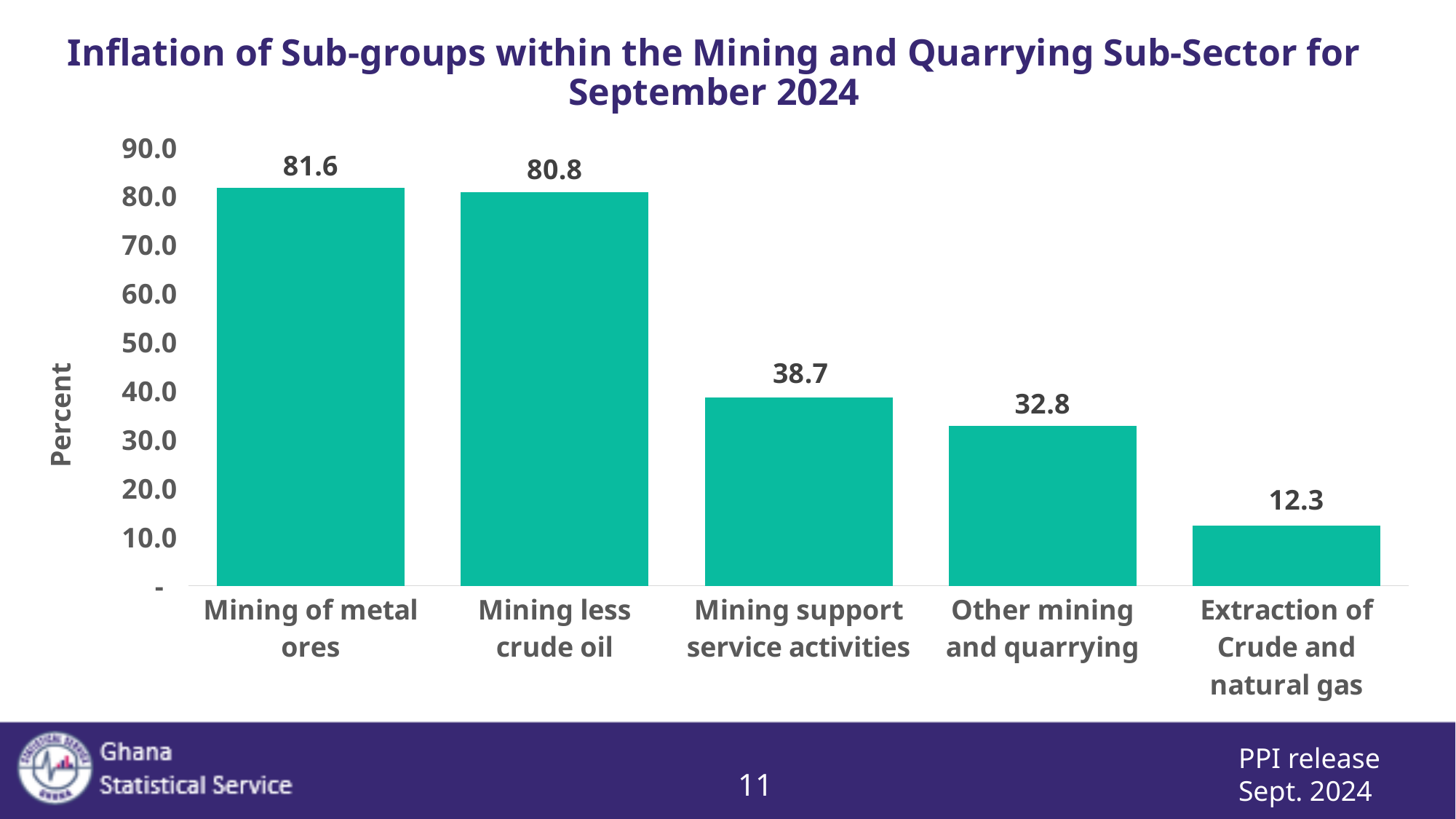
What kind of chart is shown on the slide? Bar chart What is the inflation value for Mining support service activities? 38.7 What is the inflation value for Extraction of Crude and natural gas? 12.3 Do the values rise or fall from left to right across the categories? Fall Which has a higher inflation value: Other mining and quarrying or Extraction of Crude and natural gas? Other mining and quarrying What is the label on the vertical axis? Percent Which sub-group has the lowest inflation? Extraction of Crude and natural gas Is the value for Mining less crude oil greater or less than 70.0? greater Which sub-group has the highest inflation? Mining of metal ores How many sub-groups are shown in the chart? 5 What is the difference between the inflation values for Mining support service activities and Other mining and quarrying? 5.9 What is the inflation value for Mining of metal ores? 81.6